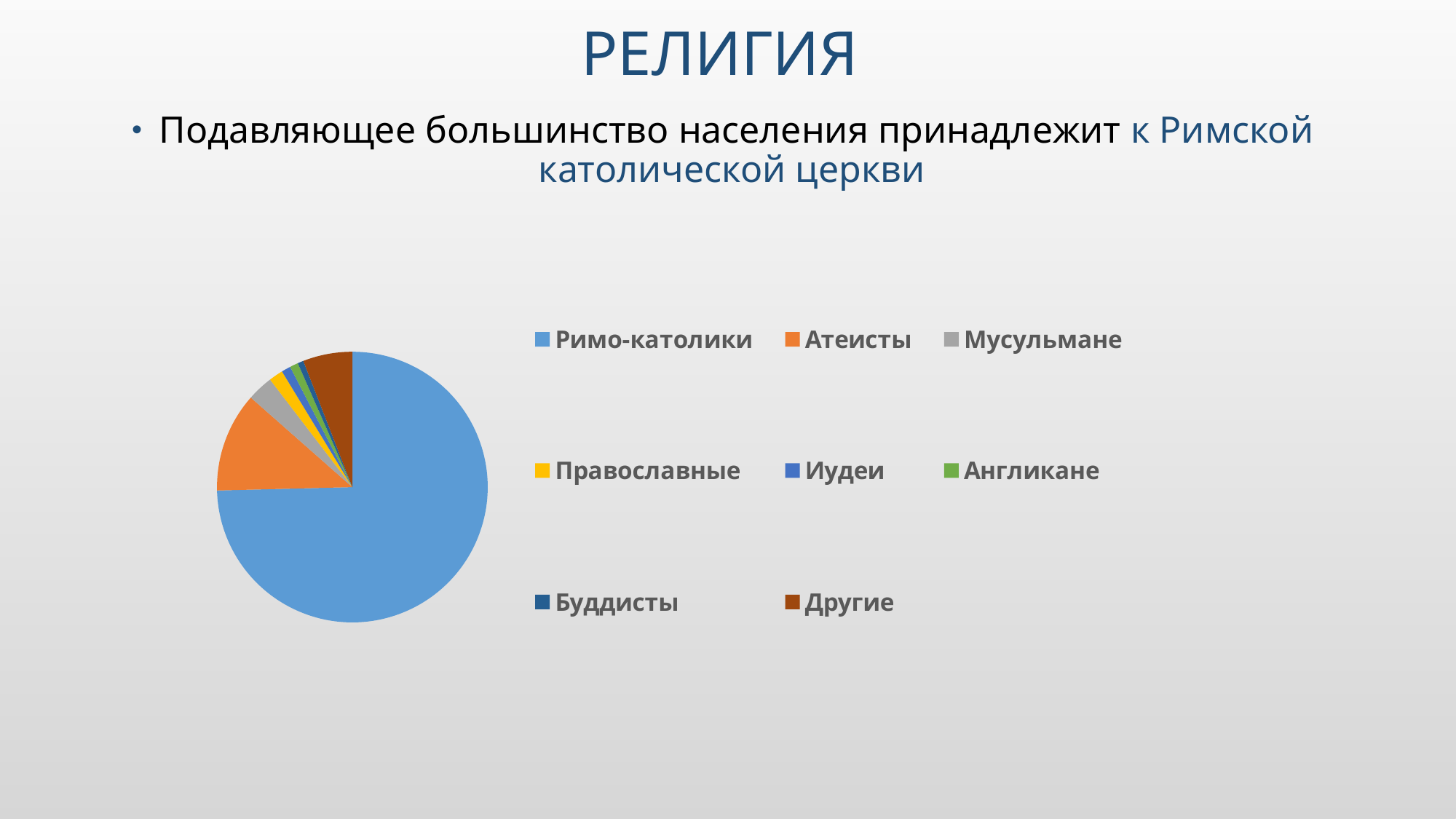
Which slice is larger, Другие or Православные? Другие Which slice is larger, Римо-католики or Атеисты? Римо-католики Which category is shown in orange in the pie chart? Атеисты Which slice is larger, Атеисты or Мусульмане? Атеисты How many categories does the pie chart's legend list? 8 What kind of chart is shown on the slide? pie chart What colour represents Римо-католики in the pie chart? blue Which category has the largest slice of the pie chart? Римо-католики Does the Римо-католики slice take up more or less than half of the pie? more Which category has the second-largest slice of the pie chart? Атеисты